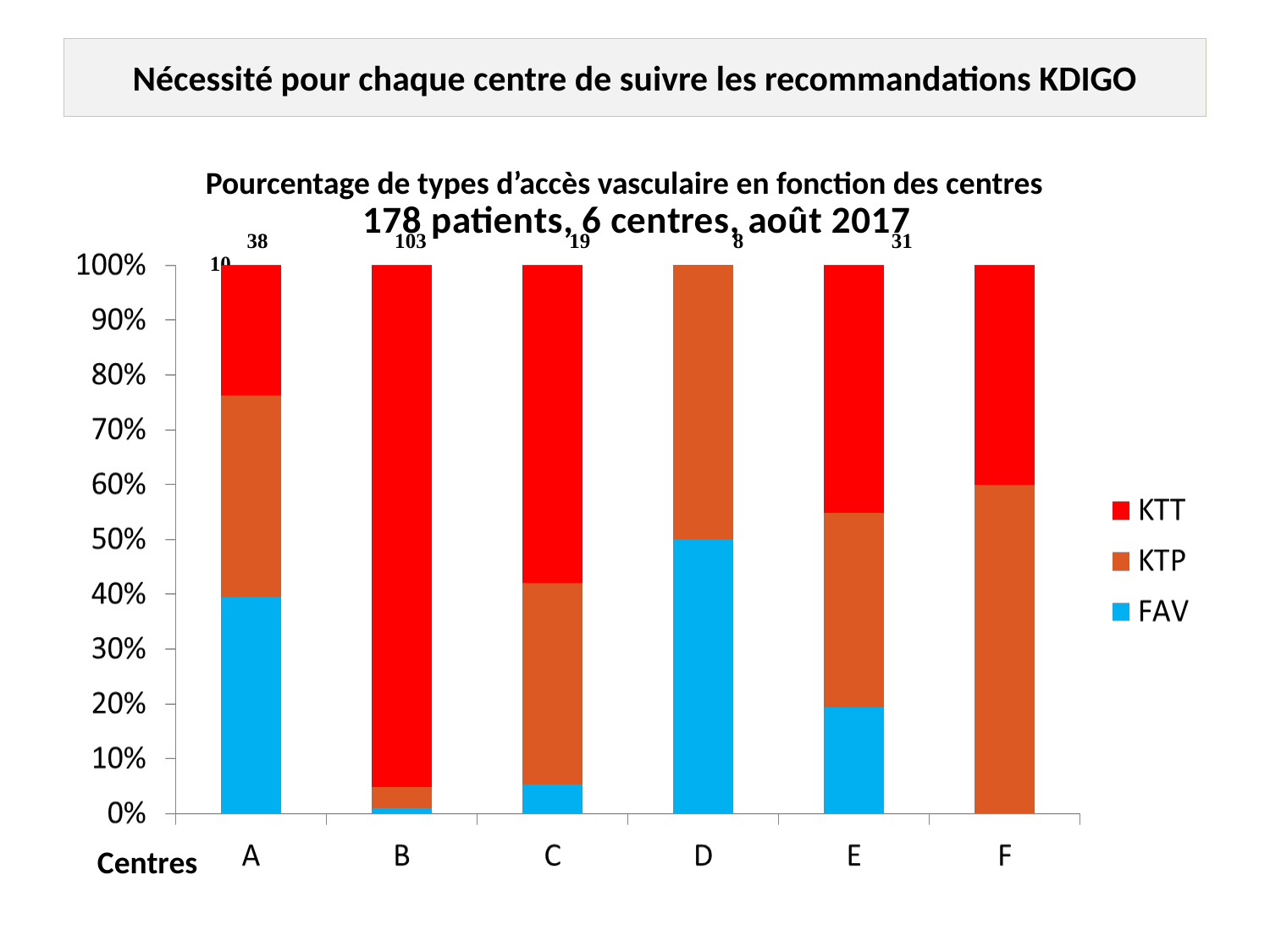
Which centre has the larger FAV share, A or E? A What is the KTP percentage for centre F? 60% Is the FAV value for centre C greater or less than 10%? less How many series does the legend list? 3 How many centres are shown on the x axis? 6 What kind of chart is shown on the slide? Stacked bar chart Is the FAV value for centre A greater or less than 30%? greater Which centre has the largest FAV share? D Which centre has no FAV segment at all? F What are the three series named in the legend? KTT, KTP, FAV Which centre has the largest KTT share? B What is the FAV percentage for centre D? 50%